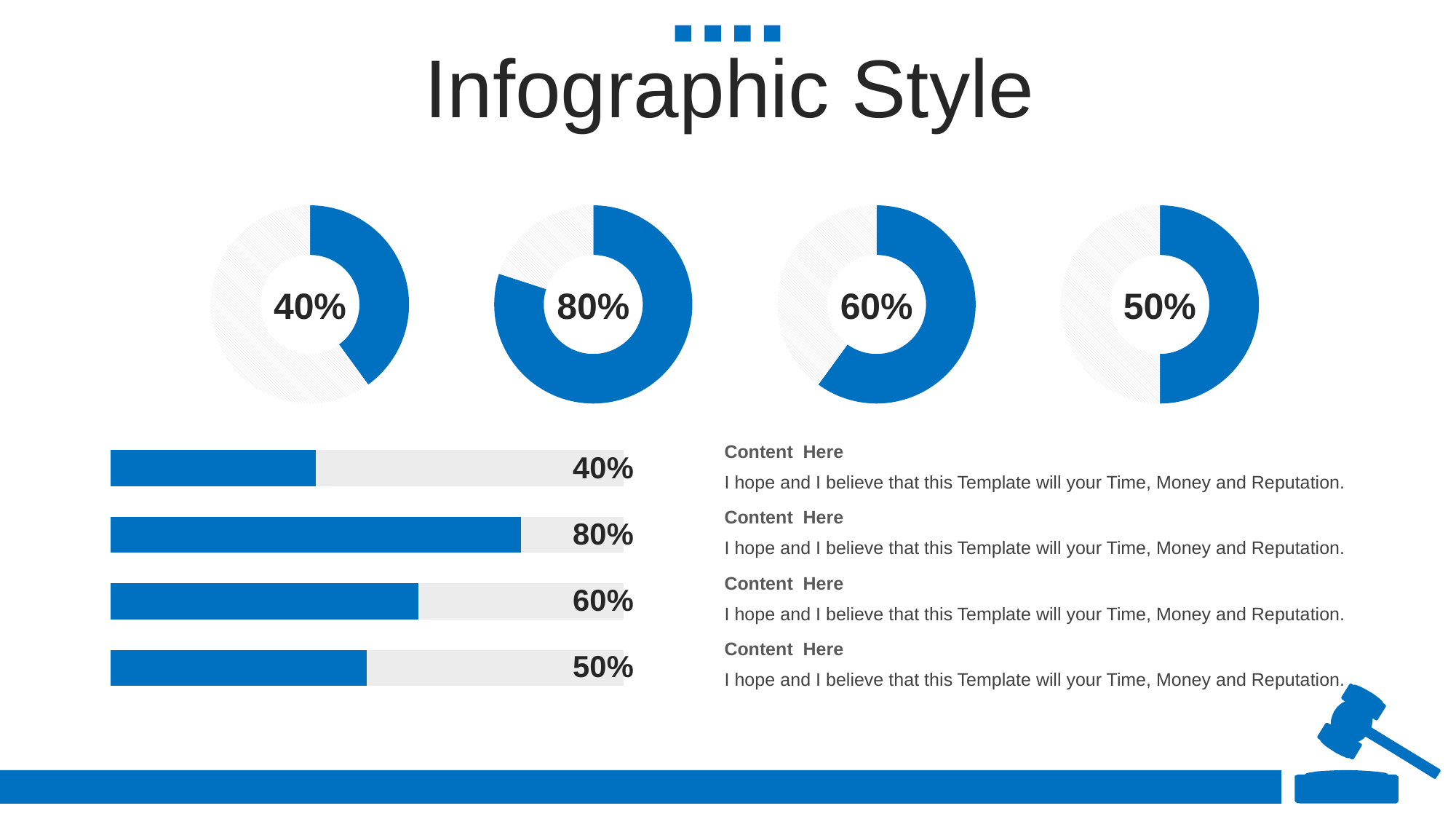
What value is shown in the leftmost donut chart? 40% In the horizontal bar chart, what is the value of the second bar from the top? 80% What type of chart is shown in the lower-left part of the slide? Bar chart In the horizontal bar chart, which is larger: the third bar or the bottom bar? The third bar (60%) Which donut chart shows the lowest percentage? The leftmost (40%) In the horizontal bar chart, what is the difference between the second bar (80%) and the top bar (40%)? 40% How many donut charts are shown on the slide? 4 How many bars are in the horizontal bar chart? 4 In the horizontal bar chart, what is the value of the bottom bar? 50% Which donut chart shows the highest percentage? The second from the left (80%) What value is shown in the second donut chart from the left? 80% What value is shown in the rightmost donut chart? 50%